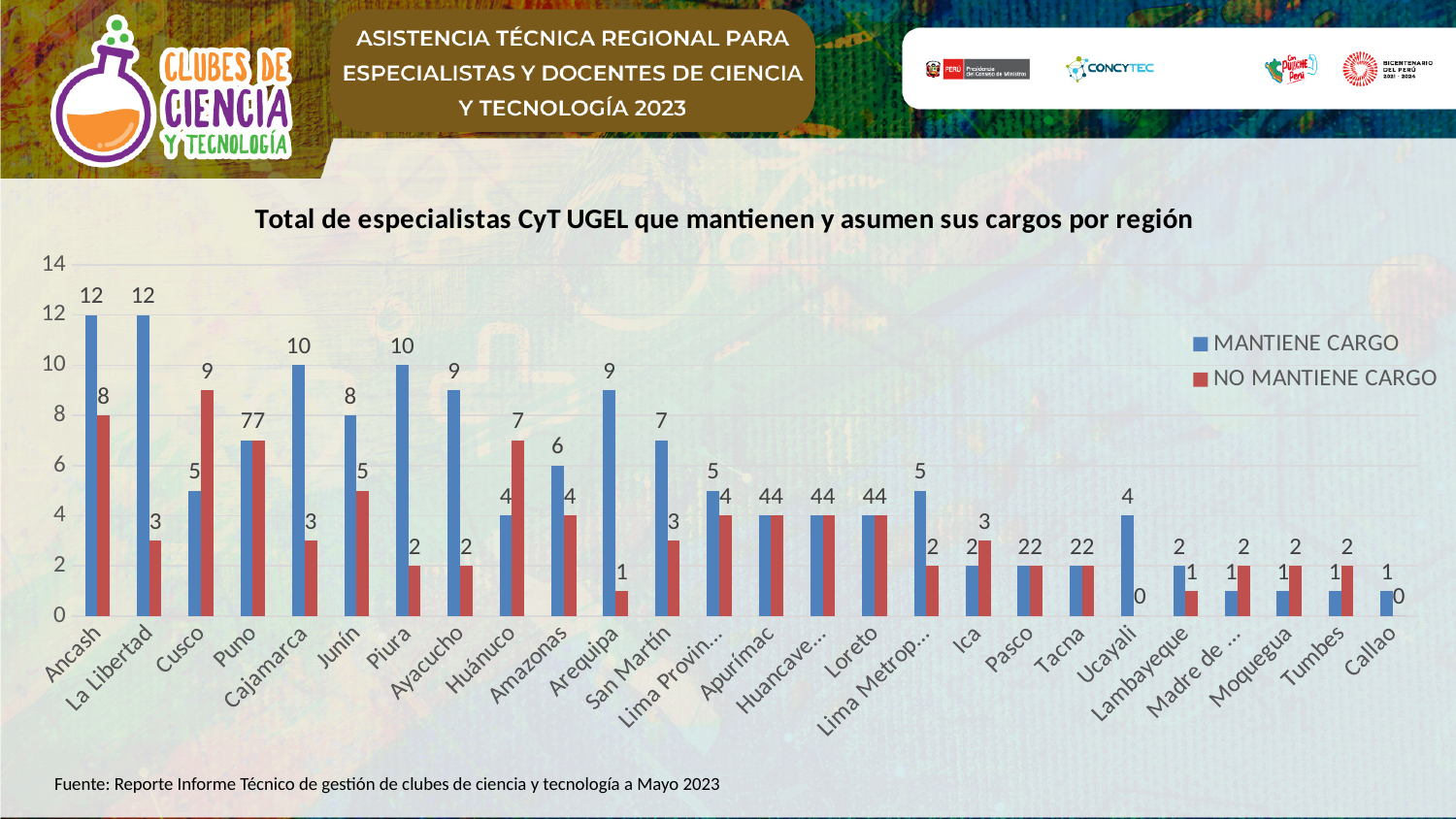
What is the difference between the MANTIENE CARGO and NO MANTIENE CARGO values for Arequipa? 8 What is the title of the chart? Total de especialistas CyT UGEL que mantienen y asumen sus cargos por región Which has a larger NO MANTIENE CARGO value, Piura or Ica? Ica What is the NO MANTIENE CARGO value for Ucayali? 0 What kind of chart is shown on the slide? Bar chart Which region has the highest NO MANTIENE CARGO value? Cusco Which has a larger MANTIENE CARGO value, Cajamarca or Junín? Cajamarca What is the MANTIENE CARGO value for Cusco? 5 How many regions are shown on the x axis of the chart? 26 What is the NO MANTIENE CARGO value for Huánuco? 7 How many series does the legend list? 2 What is the difference between the MANTIENE CARGO and NO MANTIENE CARGO values for Ancash? 4